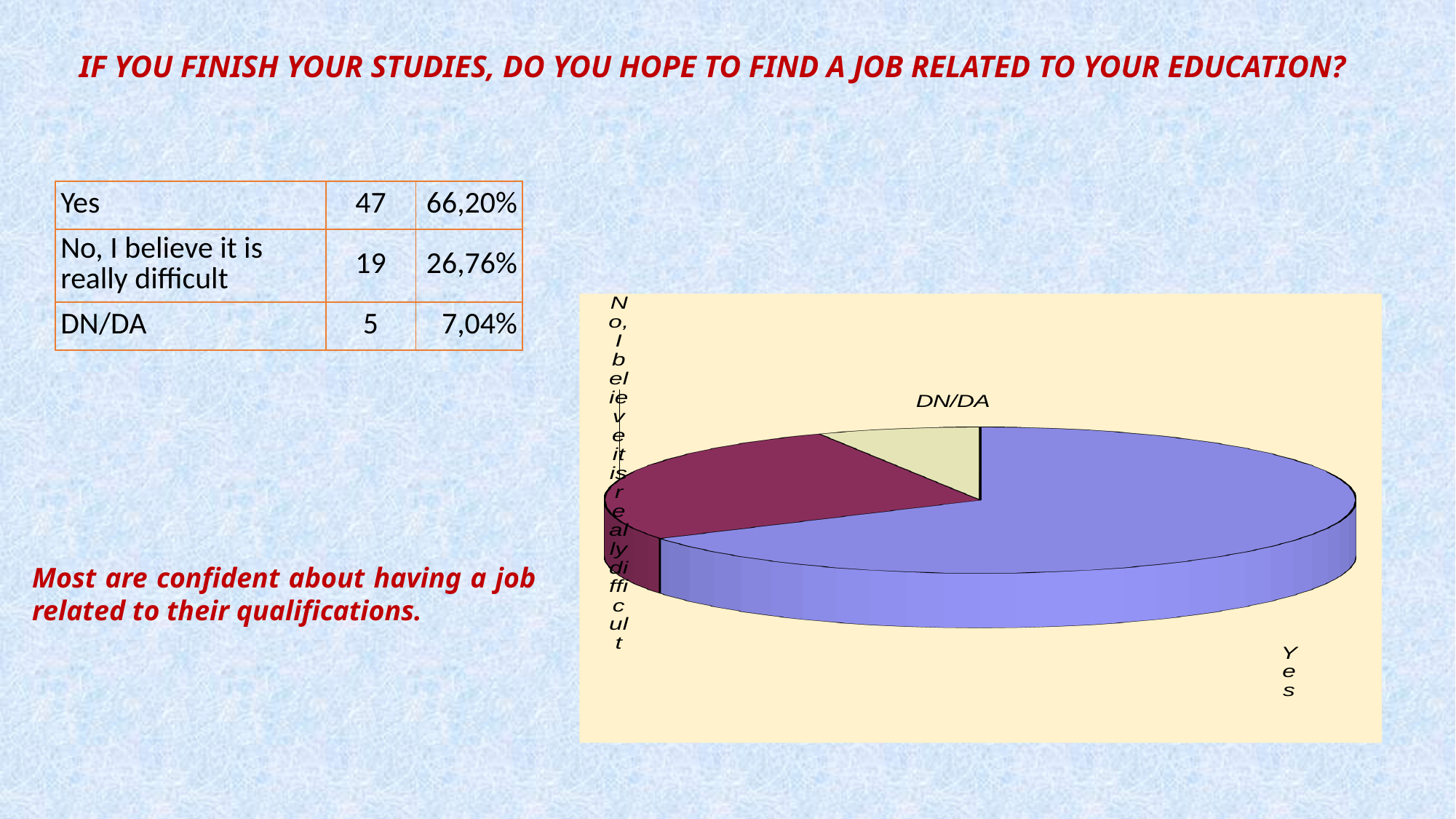
According to the table on the slide, how many respondents answered 'Yes'? 47 Is the slice for 'Yes' larger or smaller than the slice for 'No, I believe it is really difficult'? larger How many slices does the pie chart have? 3 What kind of chart is shown on the slide? pie chart Which category has the smallest slice in the pie chart? DN/DA Is the slice for 'DN/DA' larger or smaller than the slice for 'No, I believe it is really difficult'? smaller Using the counts in the table, what is the difference between the number of 'Yes' responses and the number of 'DN/DA' responses? 42 According to the table on the slide, what percentage share does the 'DN/DA' slice represent? 7,04% According to the table on the slide, how many respondents answered 'No, I believe it is really difficult'? 19 Which category has the largest slice in the pie chart? Yes According to the table on the slide, what percentage share does the 'Yes' slice represent? 66,20% What colour is the 'Yes' slice in the pie chart? blue